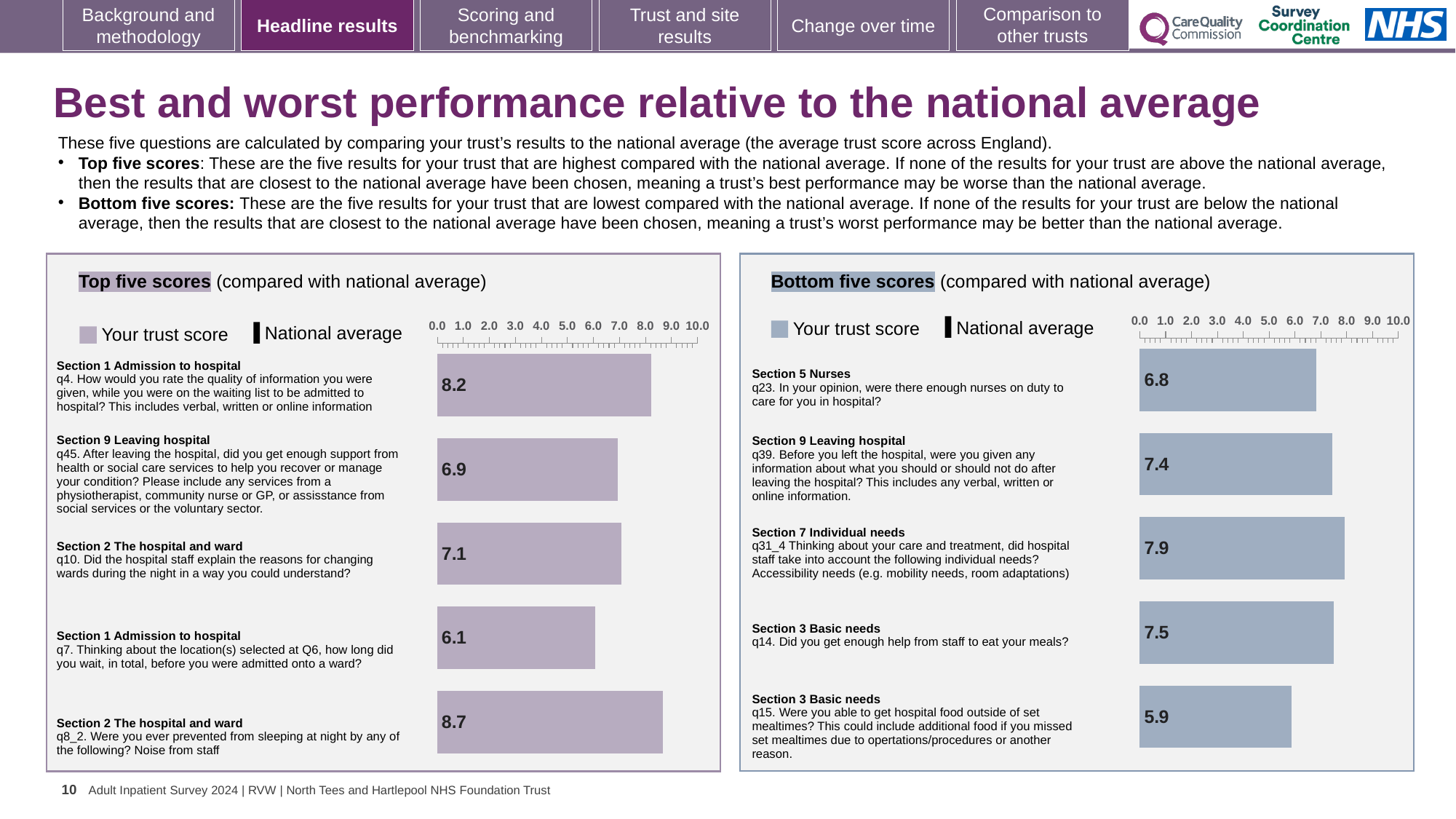
In the Top five scores chart, what is the trust score for q4 about the quality of information given while on the waiting list? 8.2 What type of chart is used in the Top five scores panel? Bar chart In the Top five scores chart, which question has the lowest trust score? q7 (how long did you wait before being admitted onto a ward) In the Bottom five scores chart, which question has the lowest trust score? q15 (hospital food outside of set mealtimes) In the Top five scores chart, what is the trust score for q8_2 about being prevented from sleeping at night by noise from staff? 8.7 In the Top five scores chart, which question has the highest trust score? q8_2 (noise from staff) In the Bottom five scores chart, what is the trust score for q15 about getting hospital food outside of set mealtimes? 5.9 In the Top five scores chart, what is the difference between the trust scores for q8_2 and q7? 2.6 How many bars are plotted in the Bottom five scores chart? 5 In the Bottom five scores chart, which question has the highest trust score? q31_4 (accessibility needs) In the Bottom five scores chart, which has the larger trust score, q39 or q14? q14 In the Bottom five scores chart, what is the trust score for q23 about whether there were enough nurses on duty? 6.8